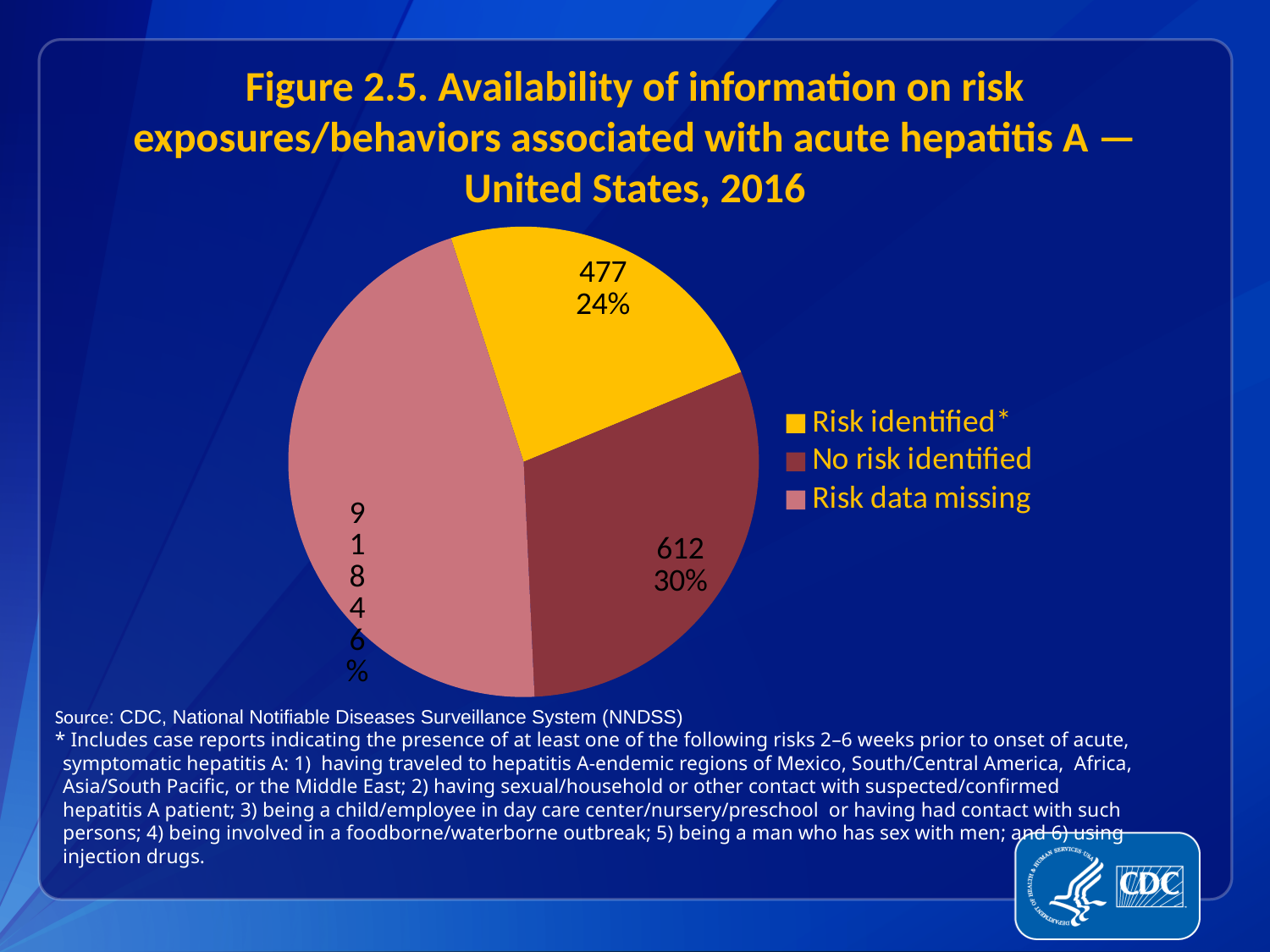
Which is larger, the 'No risk identified' slice or the 'Risk identified*' slice? No risk identified Which category has the largest slice of the pie? Risk data missing What year does the chart title say the data is for? 2016 Which category has the smallest slice of the pie? Risk identified* What colour is the 'Risk data missing' slice? Pink What percentage of the pie is the 'No risk identified' slice? 30% How many cases are in the 'Risk identified*' slice? 477 What percentage of the pie is the 'Risk identified*' slice? 24% How many categories does the legend list? 3 How many more cases are in the 'No risk identified' slice than in the 'Risk identified*' slice? 135 How many cases are in the 'No risk identified' slice? 612 What kind of chart is shown on the slide? Pie chart